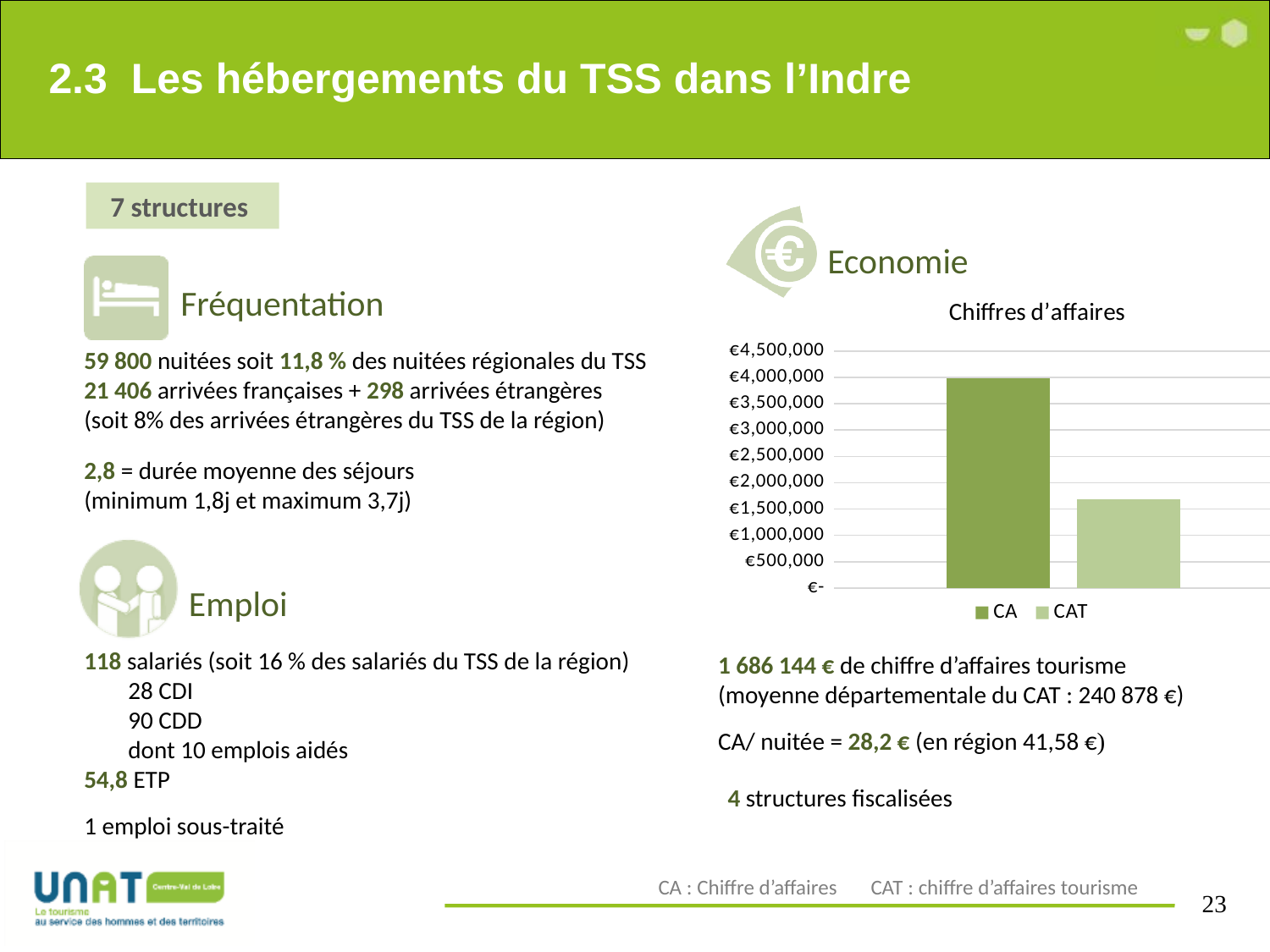
In the "Chiffres d'affaires" chart, which series has the highest value? CA What are the two legend entries of the "Chiffres d'affaires" chart? CA and CAT What is the title of the chart on the slide? Chiffres d'affaires In the "Chiffres d'affaires" chart, is the value for CAT greater or less than €2,000,000? less How many series does the legend of the "Chiffres d'affaires" chart list? 2 In the "Chiffres d'affaires" chart, which is larger, CA or CAT? CA In the "Chiffres d'affaires" chart, is the value for CAT greater or less than €1,500,000? greater In the "Chiffres d'affaires" chart, is the value for CA greater or less than €4,500,000? less What kind of chart is shown under the title "Chiffres d'affaires"? bar chart How many bars are plotted in the "Chiffres d'affaires" chart? 2 In the "Chiffres d'affaires" chart, which series has the lowest value? CAT